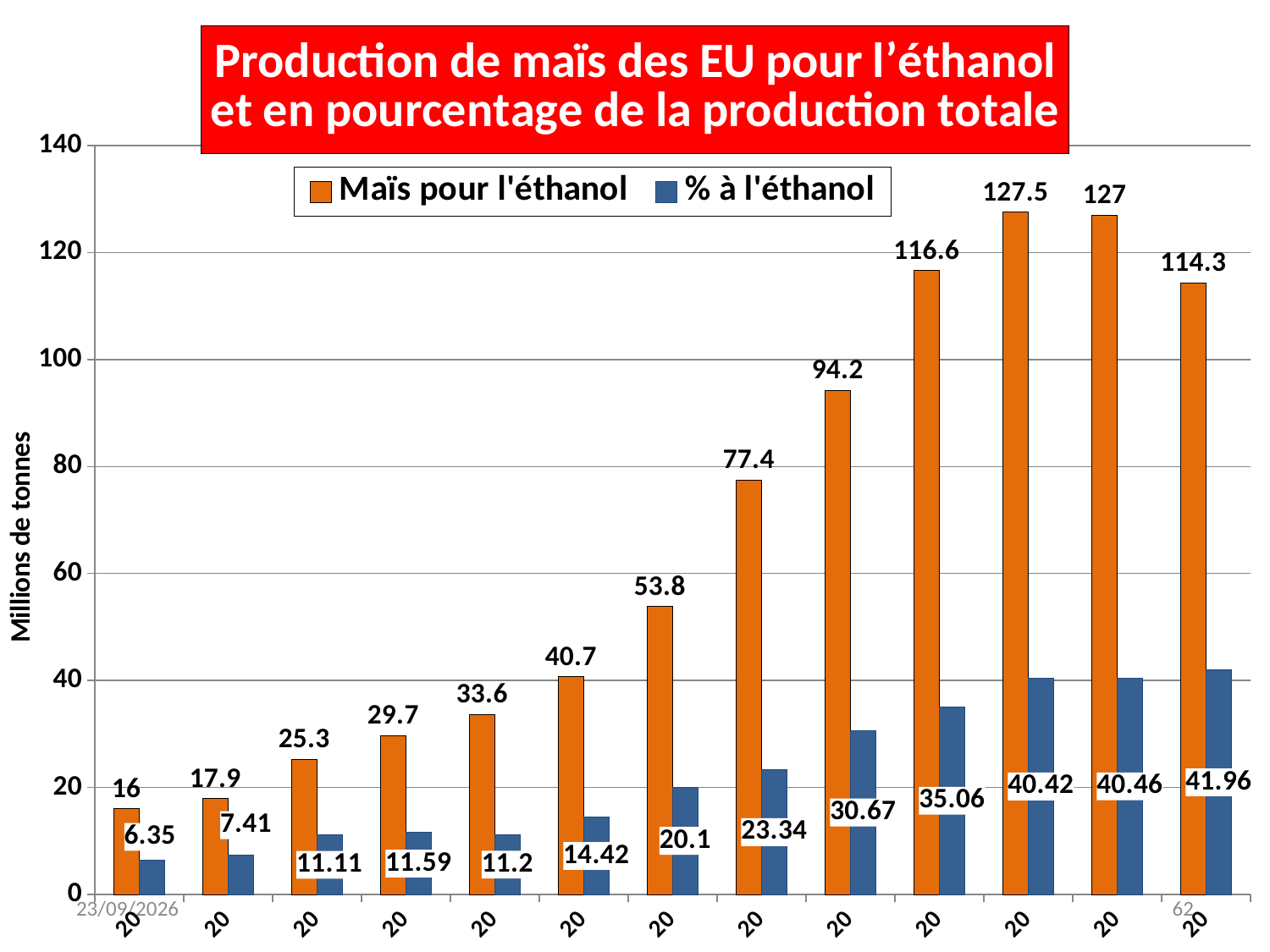
Do the '% à l'éthanol' values generally rise or fall from left to right? rise How many series does the legend list? 2 What is the lowest value shown for the '% à l'éthanol' series? 6.35 What is the '% à l'éthanol' value for the leftmost category? 6.35 What is the lowest value shown for the 'Maïs pour l'éthanol' series? 16 What is the highest value shown for the '% à l'éthanol' series? 41.96 What is the highest value shown for the 'Maïs pour l'éthanol' series? 127.5 How many categories are plotted along the x axis? 13 What is the 'Maïs pour l'éthanol' value for the rightmost category? 114.3 What is the difference between the highest 'Maïs pour l'éthanol' value (127.5) and the rightmost value (114.3)? 13.2 What kind of chart is shown on the slide? bar chart What is the label of the vertical axis? Millions de tonnes